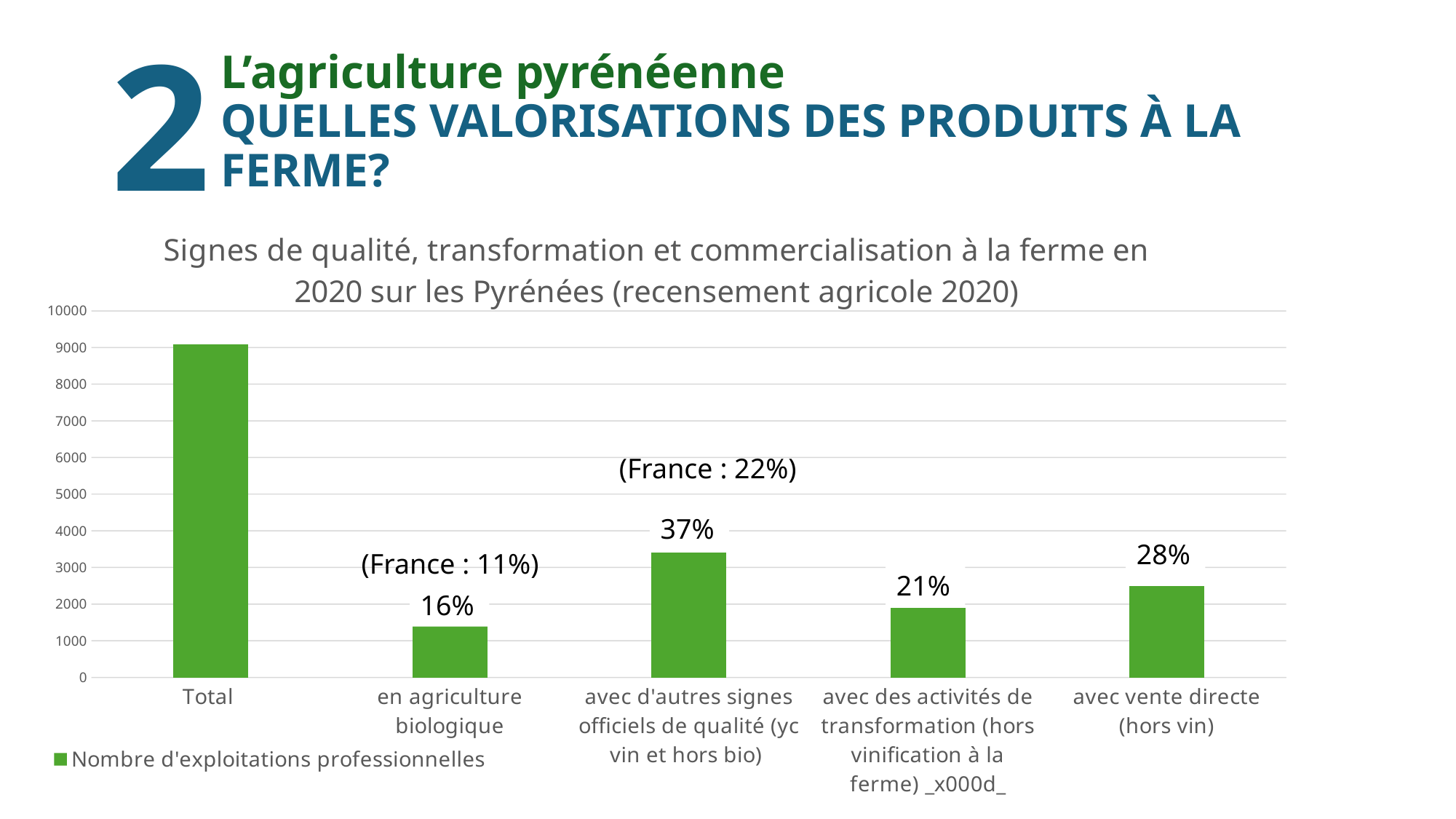
Is the value for 'Total' greater or less than 8000? greater Which bar is taller: 'avec vente directe (hors vin)' or 'avec des activités de transformation (hors vinification à la ferme)'? avec vente directe (hors vin) What percentage label is printed above the bar for 'avec d'autres signes officiels de qualité (yc vin et hors bio)'? 37% What percentage label is printed above the bar for 'en agriculture biologique'? 16% What France comparison value is shown above the 'en agriculture biologique' bar? (France : 11%) What percentage label is printed above the bar for 'avec vente directe (hors vin)'? 28% What kind of chart is shown on the slide? bar chart Which category has the highest bar in the chart? Total Which category has the lowest bar in the chart? en agriculture biologique How many categories are shown on the x axis of the chart? 5 How many series does the chart legend list? 1 What is the name of the series shown in the chart legend? Nombre d'exploitations professionnelles